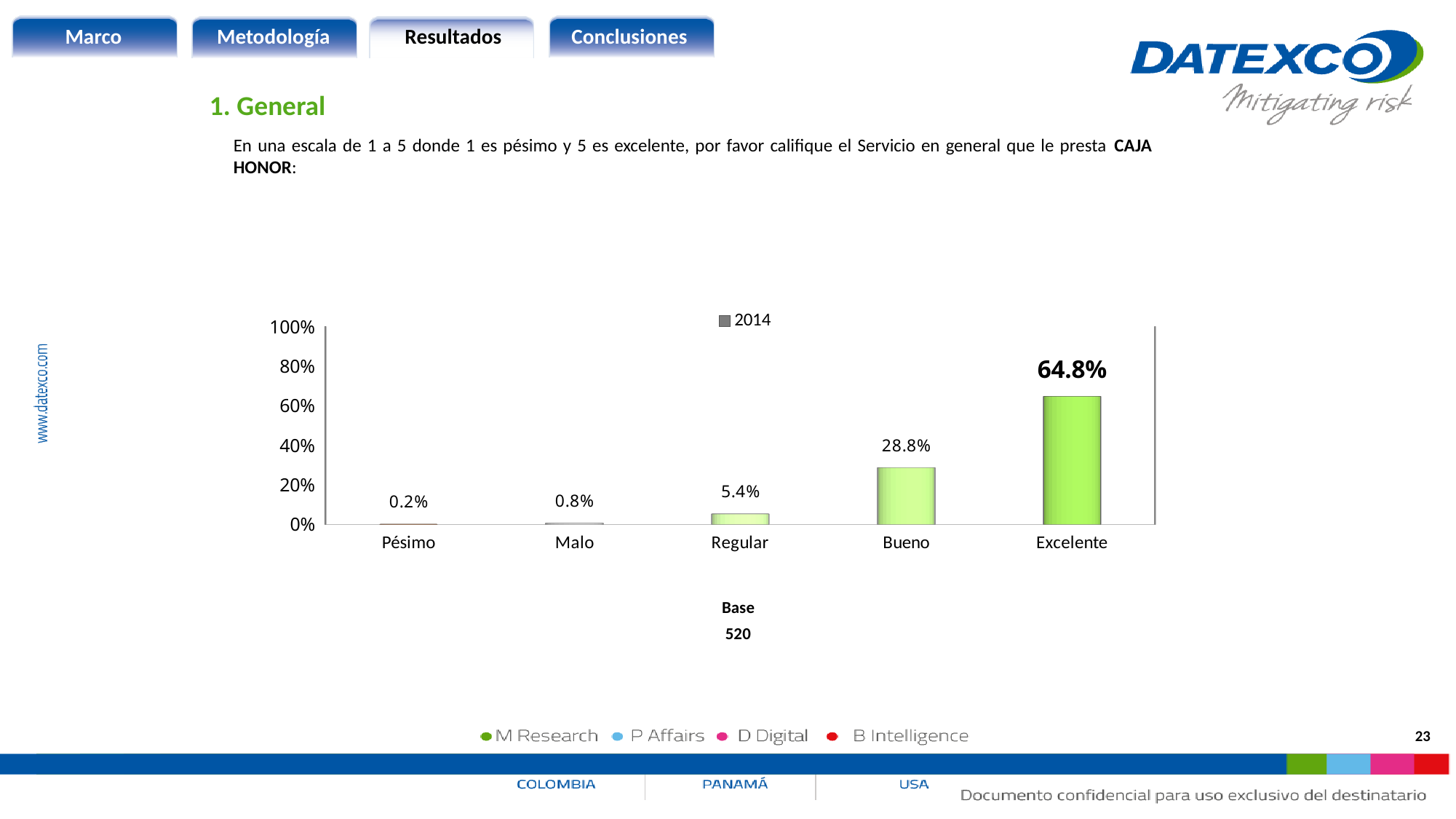
Which category has the lowest value? Pésimo Which category has the highest value? Excelente What is the value for Regular? 5.4% What is the difference between the values for Excelente and Bueno? 36.0% Is the value for Excelente greater or less than 60%? greater What is the value for Bueno? 28.8% What kind of chart is shown on the slide? bar chart Which is larger, the value for Malo or the value for Regular? Regular What series does the legend list? 2014 How many categories are shown on the x axis? 5 What is the value for Excelente? 64.8% What is the value for Pésimo? 0.2%